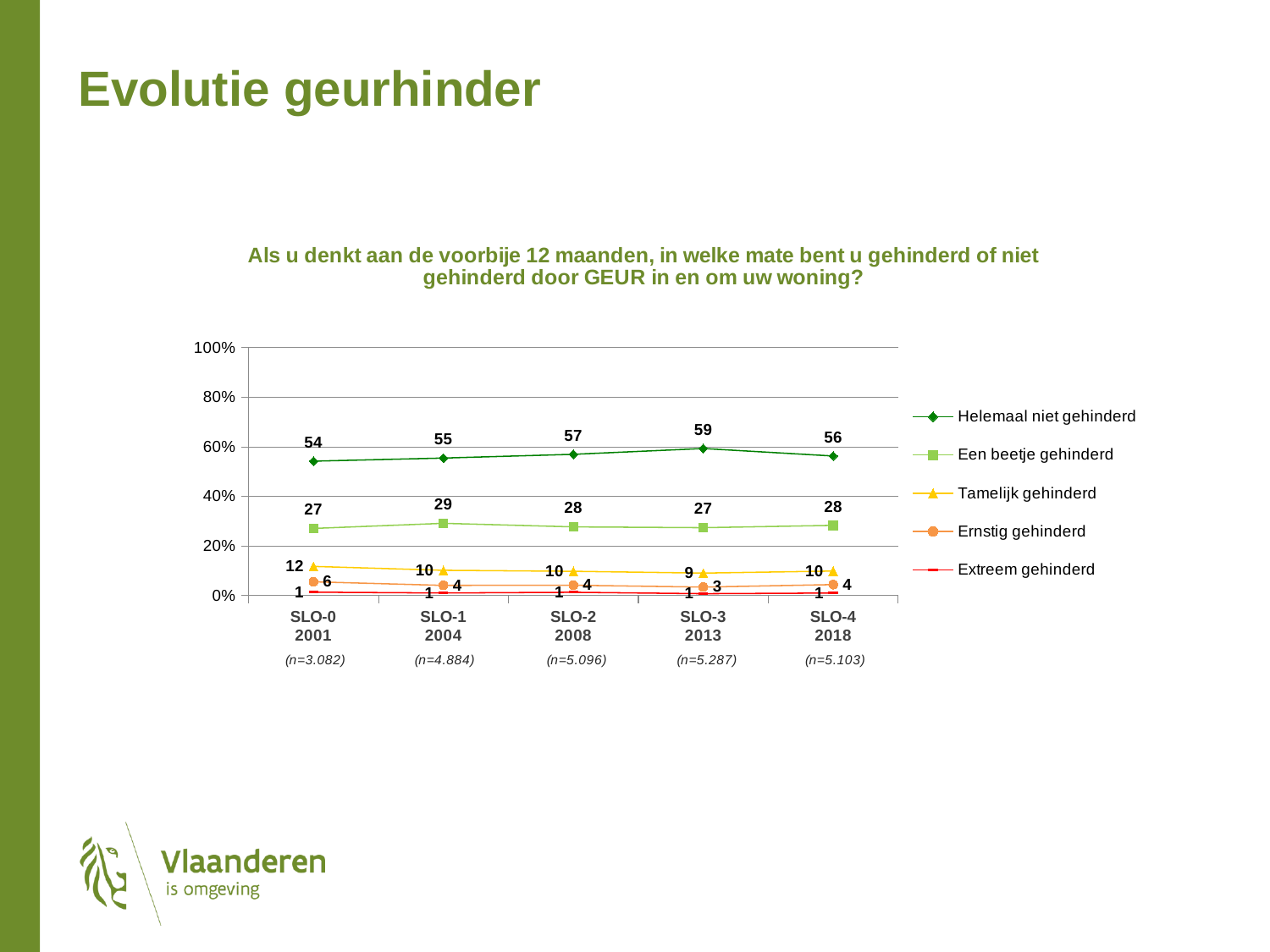
What is the value for 'Ernstig gehinderd' in SLO-3 2013? 3 What kind of chart is shown on the slide? line chart How many series does the legend list? 5 What is the difference between 'Helemaal niet gehinderd' in SLO-3 2013 and SLO-0 2001? 5 What is the value for 'Tamelijk gehinderd' in SLO-0 2001? 12 What is the value for 'Een beetje gehinderd' in SLO-1 2004? 29 In which survey wave is 'Ernstig gehinderd' highest? SLO-0 2001 What is the value for 'Helemaal niet gehinderd' in SLO-3 2013? 59 In which survey wave is 'Helemaal niet gehinderd' highest? SLO-3 2013 How many survey waves (categories) are plotted along the x axis? 5 Which is larger: 'Een beetje gehinderd' in SLO-1 2004 or in SLO-3 2013? SLO-1 2004 What is the sample size (n) shown for SLO-4 2018? n=5.103